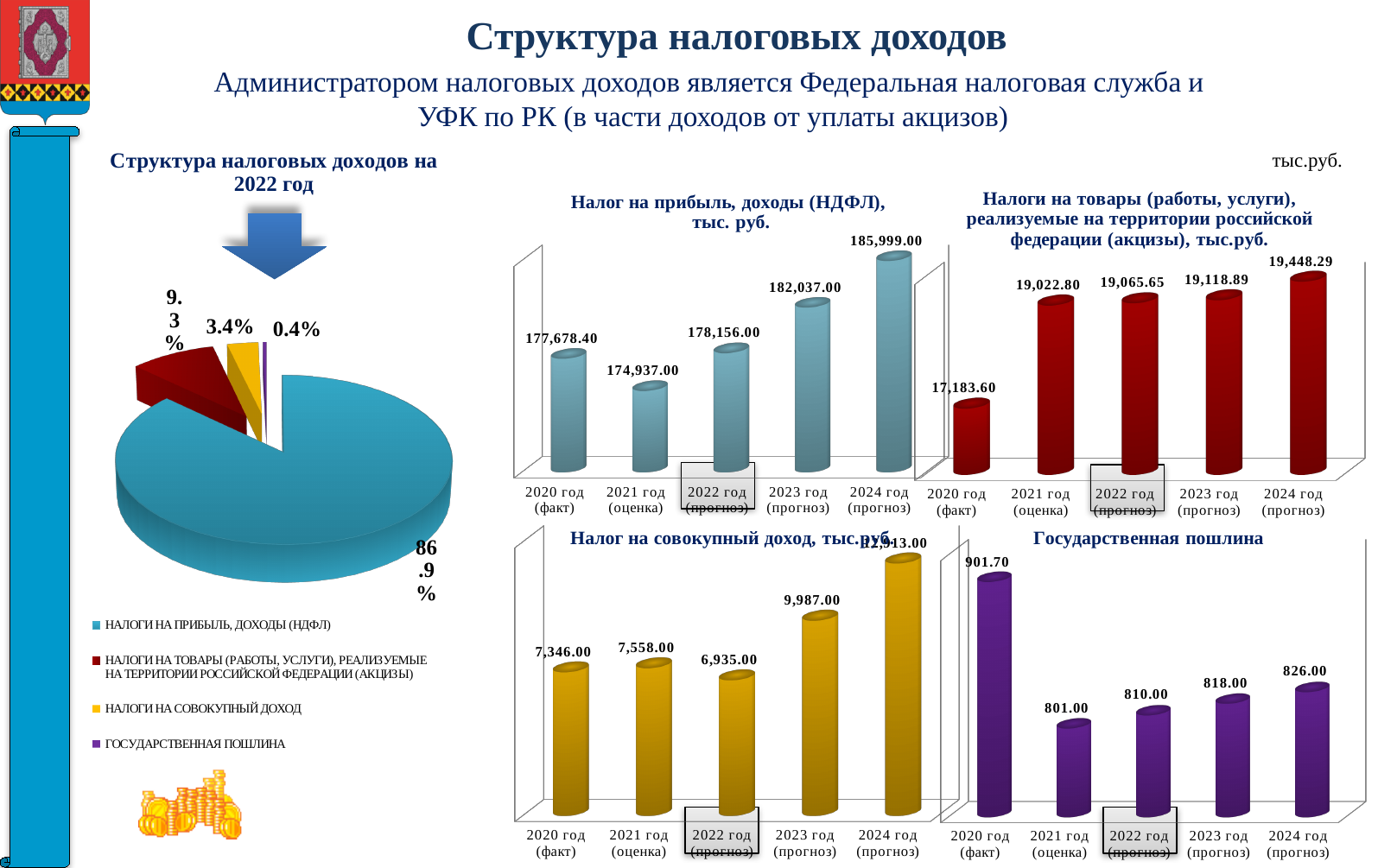
On the chart 'Налог на совокупный доход, тыс.руб.', which is larger: the value for 2021 год (оценка) or 2022 год (прогноз)? 2021 год (оценка) On the pie chart 'Структура налоговых доходов на 2022 год', what share does 'ГОСУДАРСТВЕННАЯ ПОШЛИНА' have? 0.4% On the chart 'Налог на прибыль, доходы (НДФЛ), тыс. руб.', what is the difference between the 2024 год (прогноз) and 2023 год (прогноз) values? 3,962.00 On the chart 'Государственная пошлина', what is the value for 2020 год (факт)? 901.70 On the chart 'Налог на прибыль, доходы (НДФЛ), тыс. руб.', which year has the lowest value? 2021 год (оценка) On the chart 'Налог на прибыль, доходы (НДФЛ), тыс. руб.', what is the value for 2022 год (прогноз)? 178,156.00 On the chart 'Налог на совокупный доход, тыс.руб.', what is the value for 2023 год (прогноз)? 9,987.00 On the chart 'Налоги на товары (работы, услуги), реализуемые на территории российской федерации (акцизы), тыс.руб.', what is the value for 2020 год (факт)? 17,183.60 What type of chart is 'Государственная пошлина'? Bar chart How many entries does the legend of the pie chart 'Структура налоговых доходов на 2022 год' list? 4 On the pie chart 'Структура налоговых доходов на 2022 год', what share does 'НАЛОГИ НА ПРИБЫЛЬ, ДОХОДЫ (НДФЛ)' have? 86.9% On the chart 'Налоги на товары (работы, услуги), реализуемые на территории российской федерации (акцизы), тыс.руб.', which year has the highest value? 2024 год (прогноз)